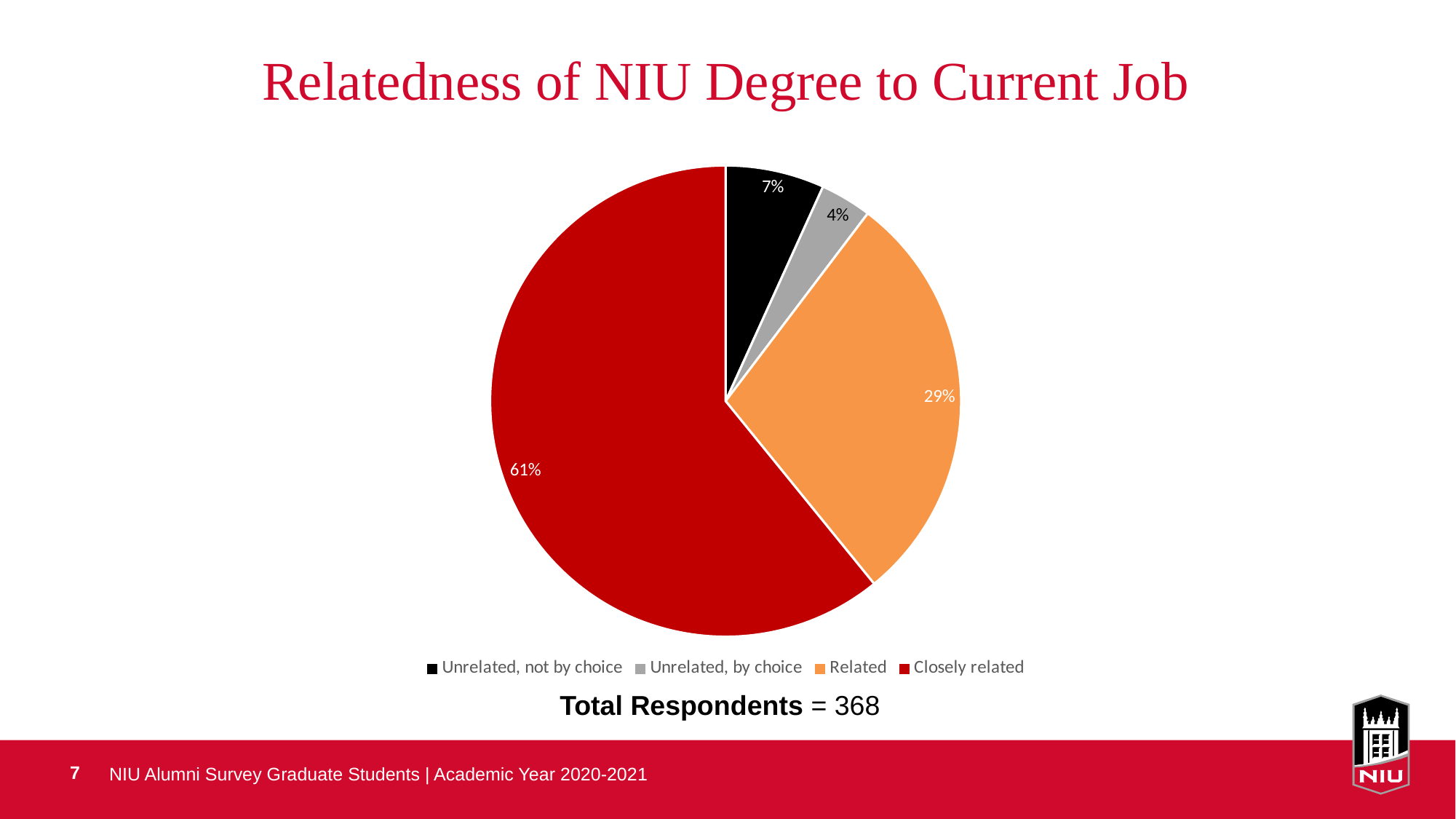
Which category has the smallest share of the pie? Unrelated, by choice What percentage of respondents chose 'Unrelated, by choice'? 4% What percentage of respondents said their NIU degree is related to their current job? 29% Which is larger: the share for 'Unrelated, not by choice' or 'Unrelated, by choice'? Unrelated, not by choice What is the total number of respondents stated below the chart? 368 What percentage of respondents said their NIU degree is closely related to their current job? 61% What percentage of respondents chose 'Unrelated, not by choice'? 7% What kind of chart is shown on the slide? pie chart What is the difference in percentage points between 'Closely related' and 'Related'? 32 How many categories does the pie chart show? 4 What is the title of the chart? Relatedness of NIU Degree to Current Job Which category has the largest share of the pie? Closely related